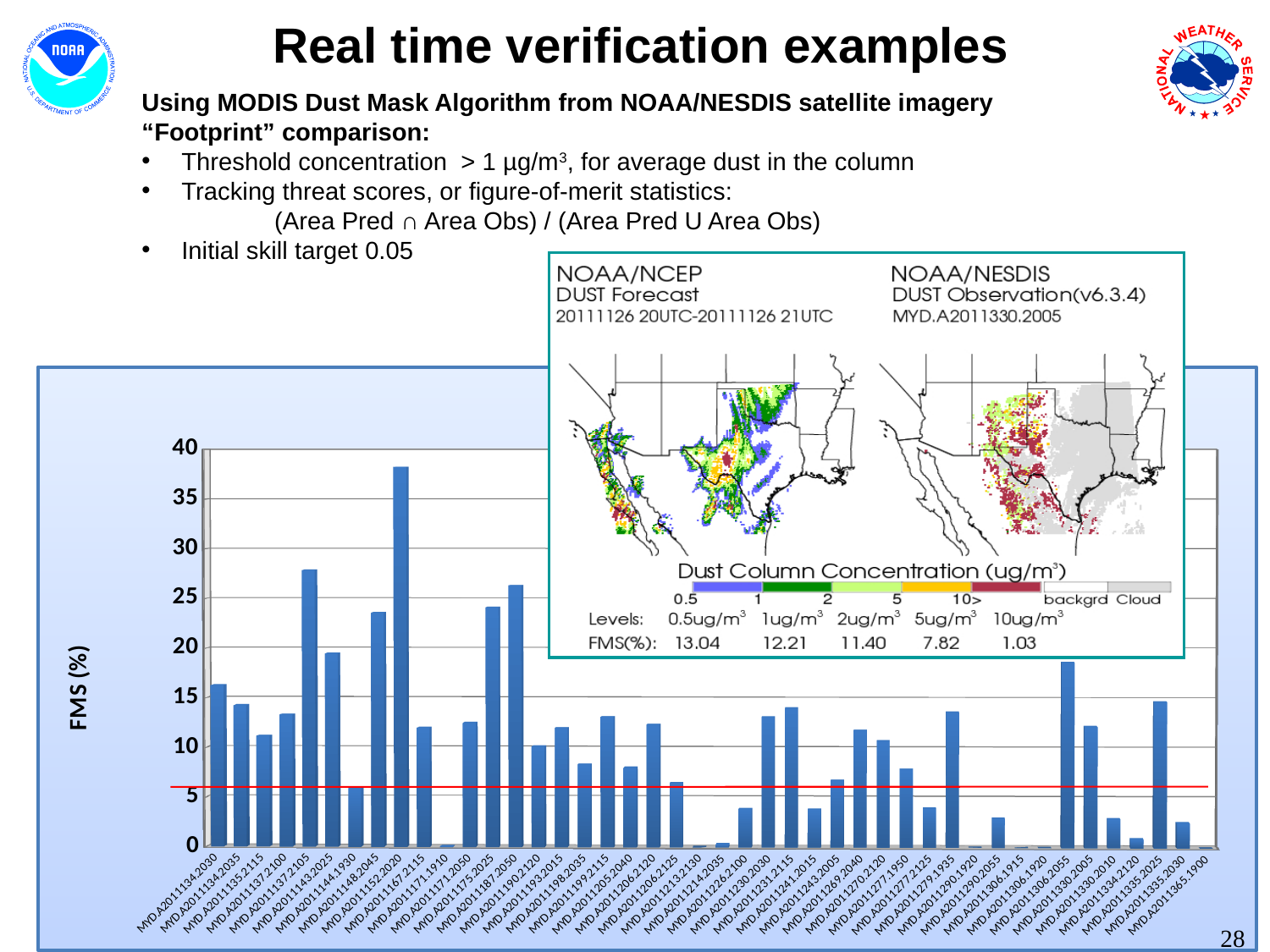
Is the value for MYD.A2011144.1930 greater or less than 10? less Is the value for MYD.A2011226.2100 greater or less than 5? less Is the value for MYD.A2011152.2020 greater or less than 35? greater Which has the larger FMS (%) value, MYD.A2011152.2020 or MYD.A2011137.2105? MYD.A2011152.2020 What is the highest value shown on the y axis of the bar chart? 40 What kind of chart is shown on the slide? bar chart What is the label of the y axis of the bar chart? FMS (%) Which has the larger FMS (%) value, MYD.A2011306.2055 or MYD.A2011306.1920? MYD.A2011306.2055 Which category has the highest FMS (%) value in the bar chart? MYD.A2011152.2020